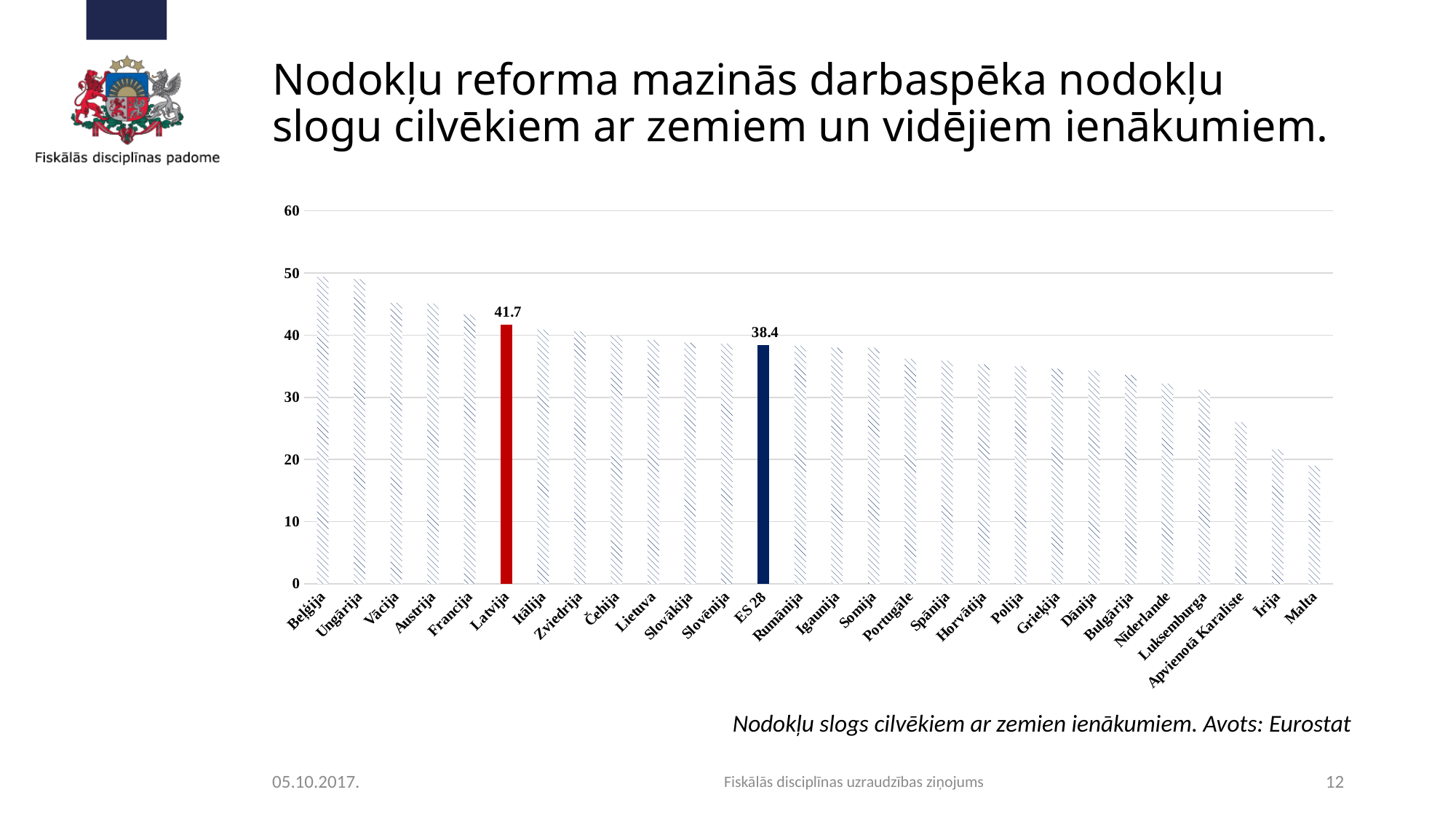
What kind of chart is shown on the slide? bar chart Do the values generally rise or fall from left to right along the x axis? fall How many categories are shown on the x axis? 28 What is the value for Latvija? 41.7 Which category has the lowest value? Malta Is the value for Beļģija greater or less than 40? greater Which is larger, the value for Latvija or the value for ES 28? Latvija What is the difference between the values for Latvija and ES 28? 3.3 Is the value for Īrija greater or less than 20? greater Is the value for Apvienotā Karaliste greater or less than 30? less What is the value for ES 28? 38.4